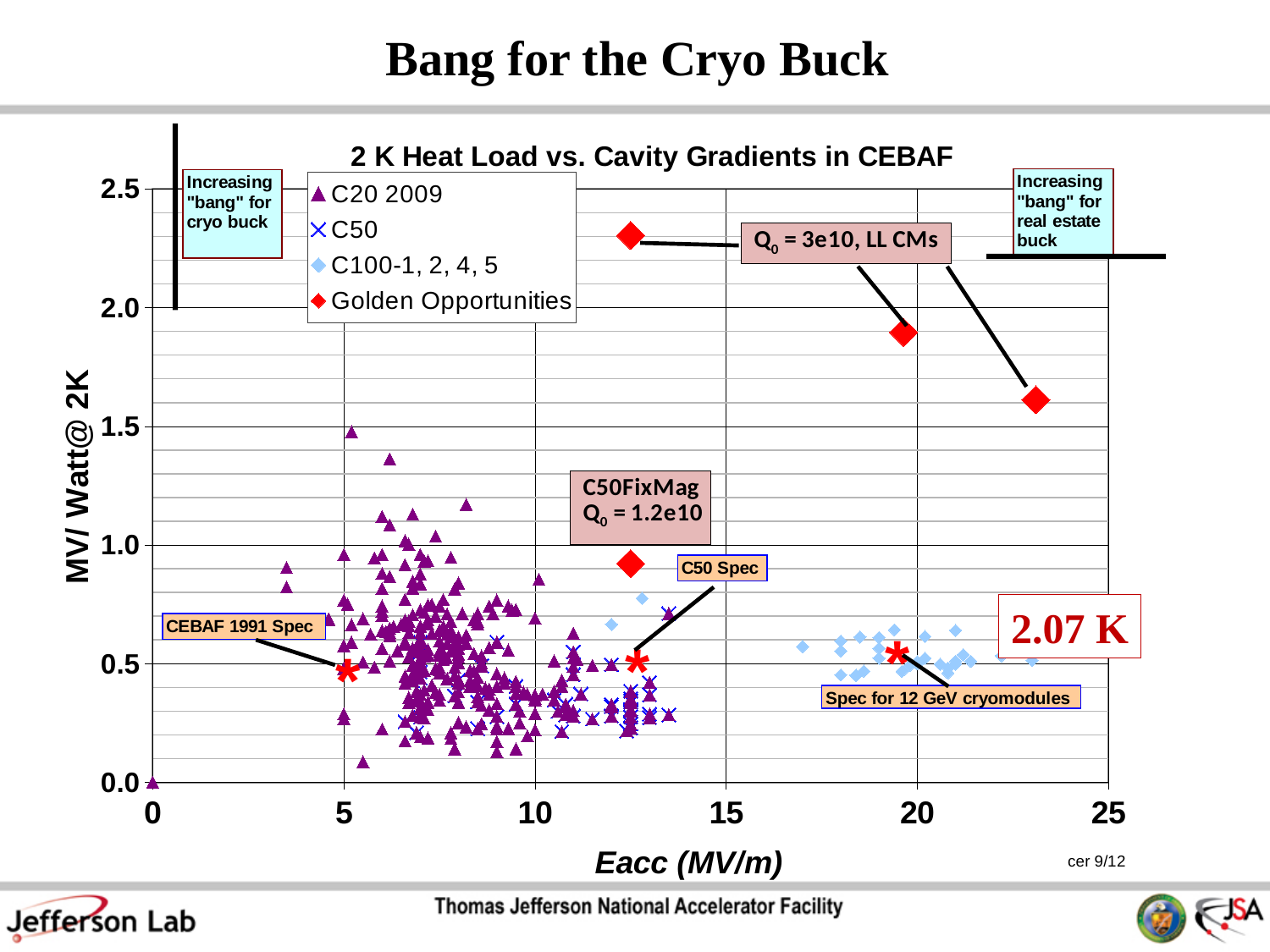
Is the value of the Golden Opportunities point near Eacc 23 greater or less than 1.5? greater How many series does the chart legend list? 4 How many Golden Opportunities points are plotted on the chart? 4 Are the C100-1, 2, 4, 5 points greater or less than 1.0 MV/Watt? less Which series contains the point with the highest MV/Watt value on the chart? Golden Opportunities What is the title of the chart? 2 K Heat Load vs. Cavity Gradients in CEBAF What is the label of the x axis? Eacc (MV/m) Is the value of the lower Golden Opportunities point near Eacc 12.5 greater or less than 1.0? less Which is higher: the top Golden Opportunities point near Eacc 12.5 or the Golden Opportunities point near Eacc 23? the point near Eacc 12.5 What kind of chart is shown on the slide? scatter chart